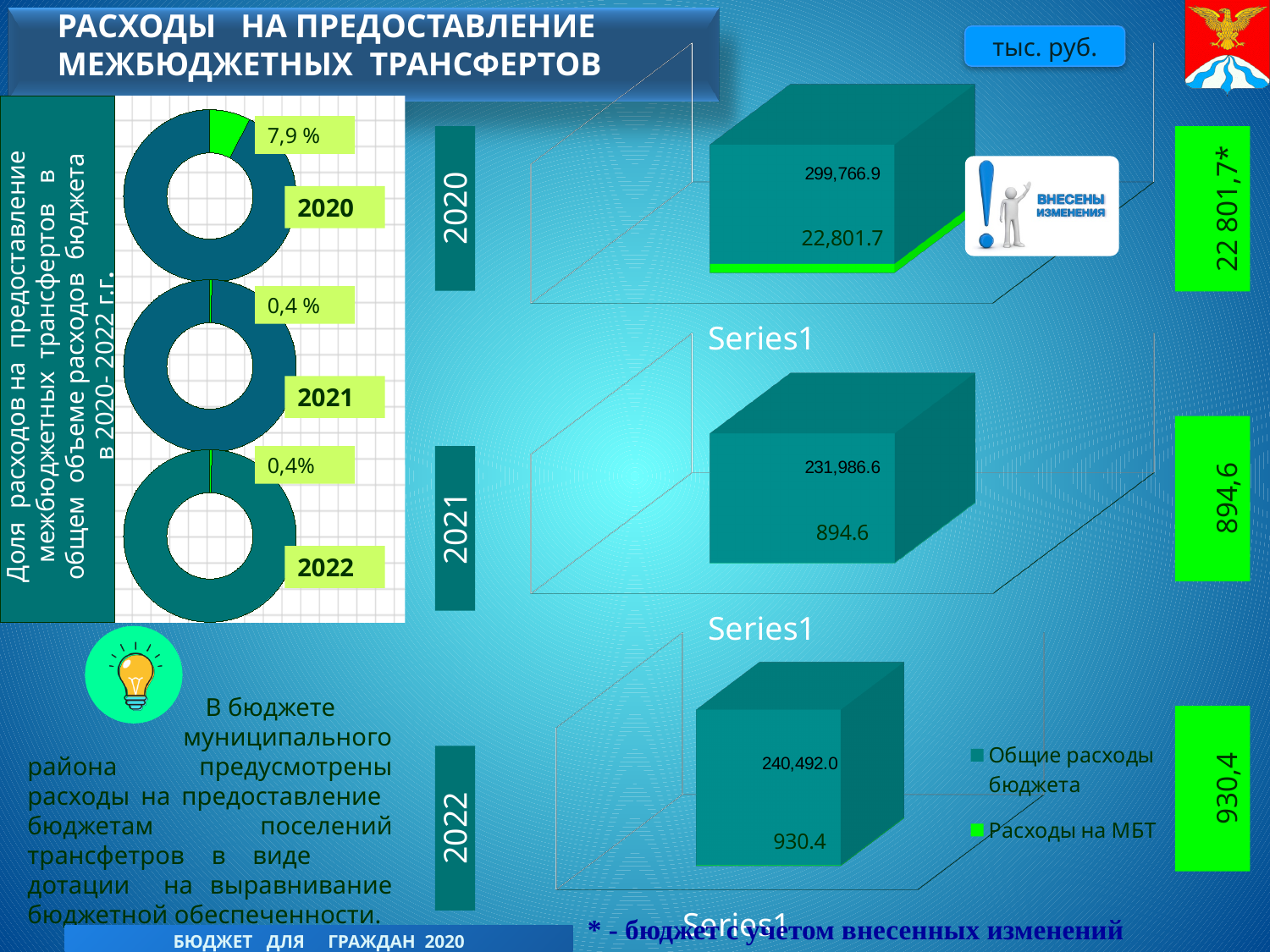
In the 2022 bar chart on the right, what value is shown for Расходы на МБТ? 930.4 Comparing the bar charts on the right, is Расходы на МБТ larger in 2021 or in 2022? 2022 How many series does the legend of the bar charts on the right list? 2 In the 2020 donut chart on the left, what share of total budget expenses is shown for intergovernmental transfers? 7,9 % In the 2020 bar chart on the right, what value is shown for Расходы на МБТ? 22,801.7 In the 2021 bar chart on the right, what value is shown for Общие расходы бюджета? 231,986.6 In the 2021 bar chart on the right, what value is shown for Расходы на МБТ? 894.6 In the 2020 bar chart on the right, what value is shown for Общие расходы бюджета? 299,766.9 In the 2022 donut chart on the left, what percentage is labelled? 0,4% In the 2022 bar chart on the right, what value is shown for Общие расходы бюджета? 240,492.0 In the 2021 donut chart on the left, what percentage is labelled? 0,4 % Among the three donut charts on the left (2020, 2021, 2022), which year shows the highest share? 2020